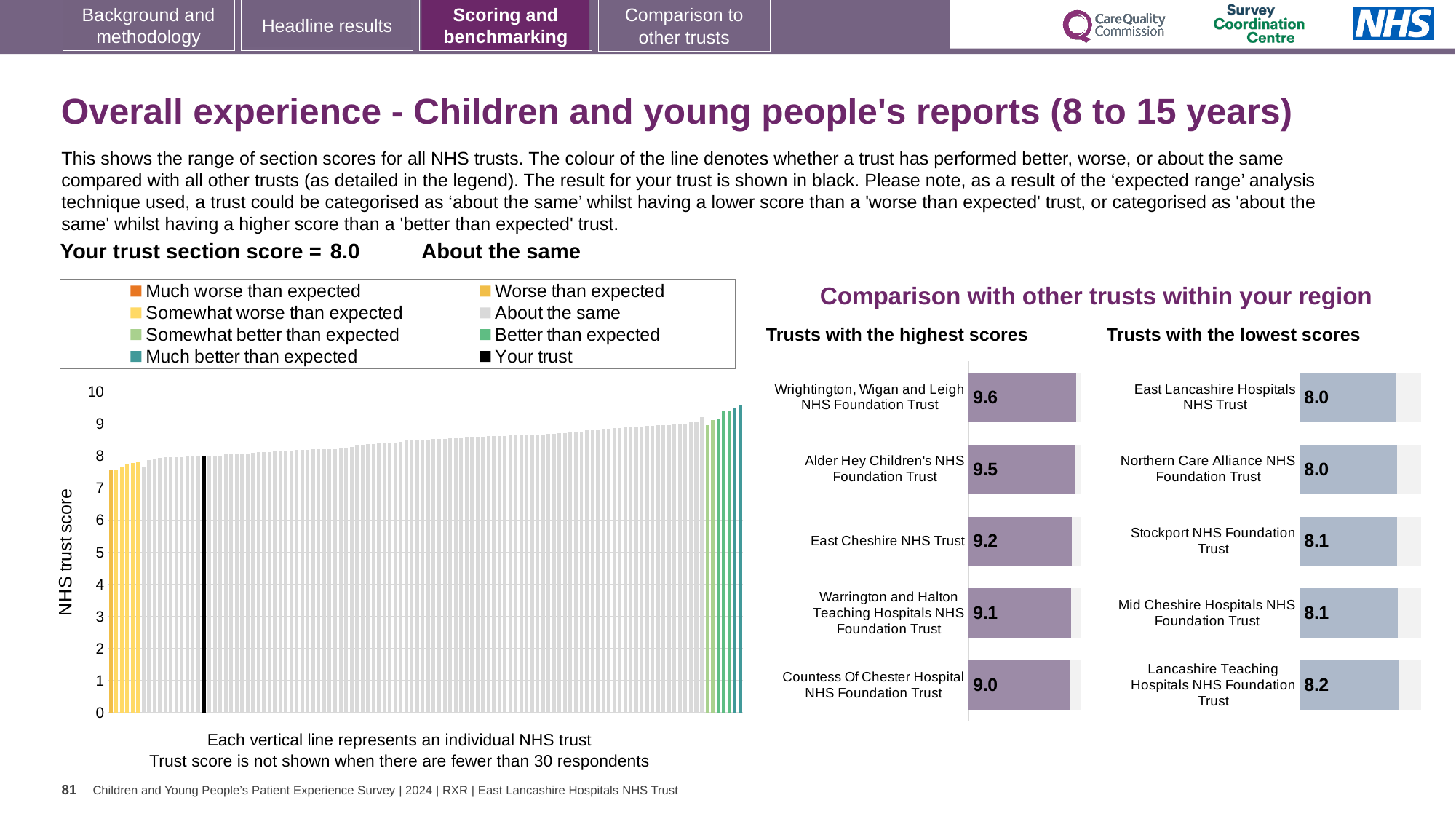
In the 'Trusts with the highest scores' chart, what is the difference between the scores of Wrightington, Wigan and Leigh NHS Foundation Trust and Countess Of Chester Hospital NHS Foundation Trust? 0.6 What kind of chart is the main chart showing the range of section scores for all NHS trusts? bar chart In the 'Trusts with the highest scores' chart, which trust has the lowest score? Countess Of Chester Hospital NHS Foundation Trust In the main chart of all NHS trusts, is the value of the leftmost (lowest) bar greater or less than 8? less In the 'Trusts with the lowest scores' chart, what is the score for Lancashire Teaching Hospitals NHS Foundation Trust? 8.2 In the 'Trusts with the highest scores' chart, which trust has the highest score? Wrightington, Wigan and Leigh NHS Foundation Trust In the 'Trusts with the highest scores' chart, what is the score for Wrightington, Wigan and Leigh NHS Foundation Trust? 9.6 How many trusts are shown in the 'Trusts with the lowest scores' chart? 5 What is the section score for your trust shown in the main chart of all NHS trusts? 8.0 How many entries does the legend of the main chart list? 8 In the 'Trusts with the highest scores' chart, what is the score for East Cheshire NHS Trust? 9.2 In the 'Trusts with the lowest scores' chart, which has the higher score: Stockport NHS Foundation Trust or East Lancashire Hospitals NHS Trust? Stockport NHS Foundation Trust